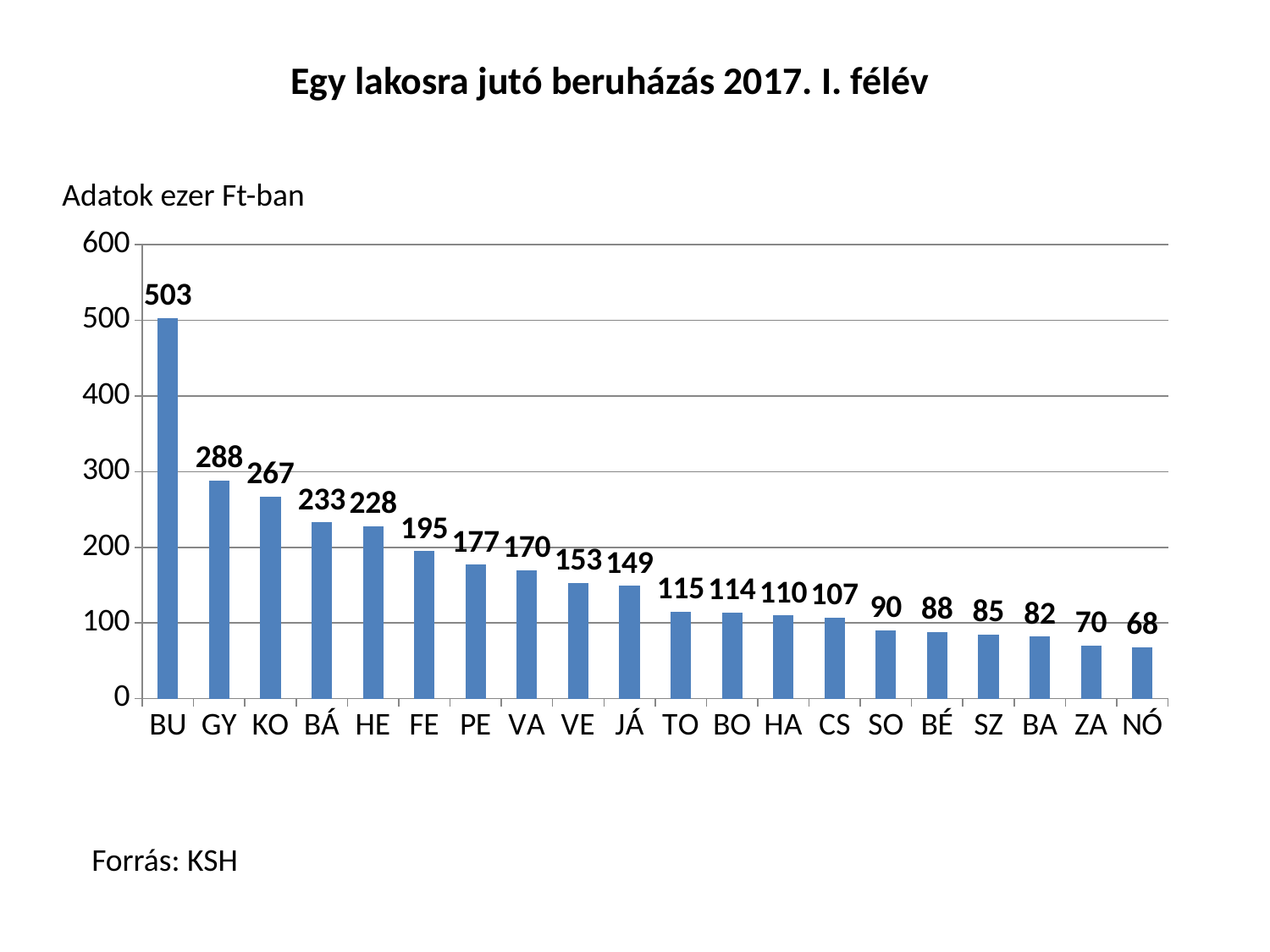
Which category has the lowest value? NÓ What is the difference between the values for FE and PE? 18 Which is larger, the value for KO or the value for BÁ? KO How many categories are shown on the x axis? 20 What is the difference between the values for BU and GY? 215 What kind of chart is this? bar chart What is the value for BU? 503 What is the value for ZA? 70 Which category has the highest value? BU What is the value for HA? 110 Is the value for VE greater or less than 200? less What is the title of the chart? Egy lakosra jutó beruházás 2017. I. félév